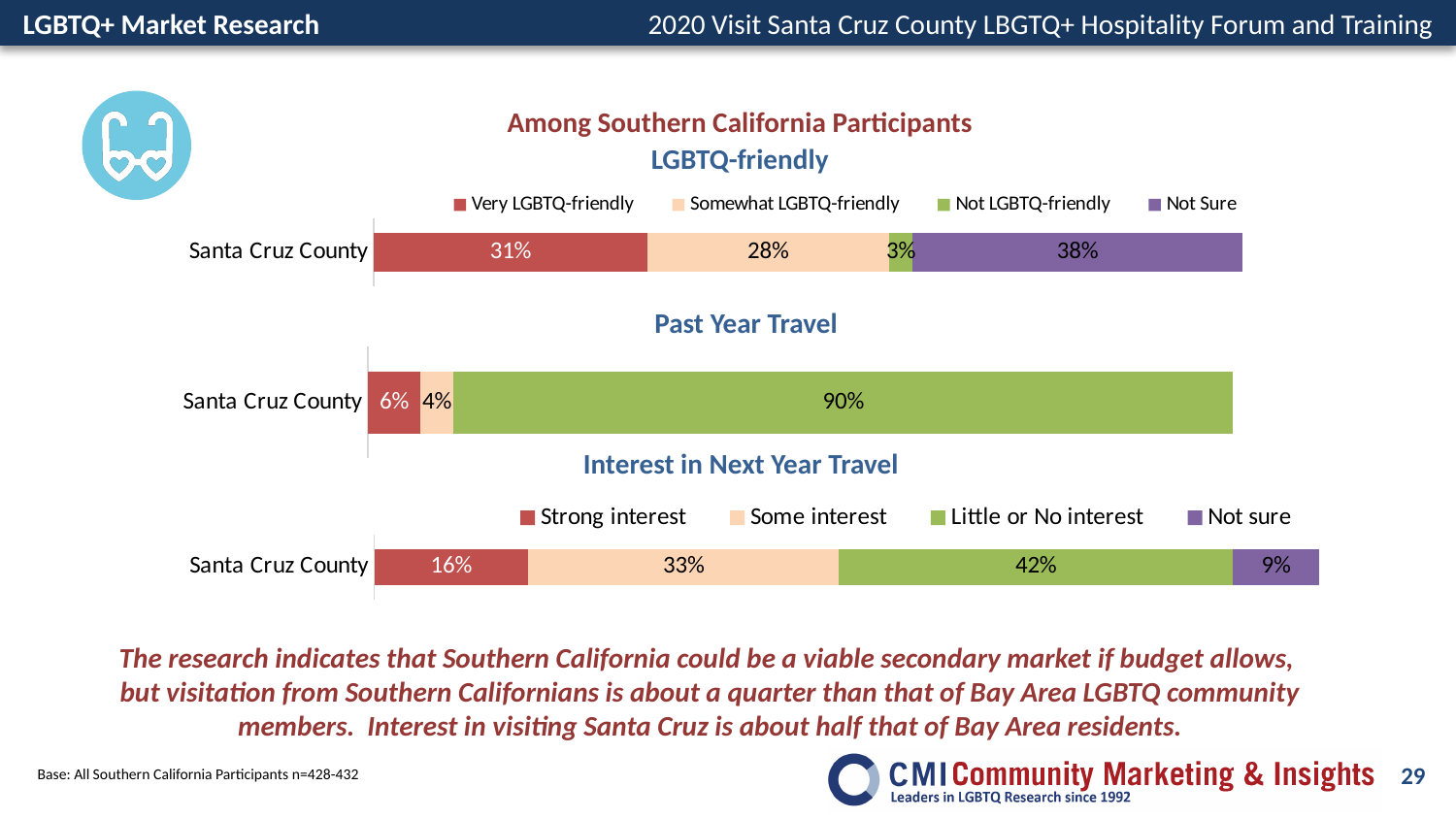
In the LGBTQ-friendly chart, what is the value for Not Sure for Santa Cruz County? 38% In the LGBTQ-friendly chart, which series has the largest value for Santa Cruz County? Not Sure In the LGBTQ-friendly chart, what is the difference between the Very LGBTQ-friendly and Somewhat LGBTQ-friendly values? 3% In the LGBTQ-friendly chart, what percentage of Southern California participants rated Santa Cruz County as Very LGBTQ-friendly? 31% In the LGBTQ-friendly chart, which series has the smallest value for Santa Cruz County? Not LGBTQ-friendly What type of chart is used for the Interest in Next Year Travel data? Stacked bar chart In the Interest in Next Year Travel chart, what is the difference between Little or No interest and Not sure? 33% In the Past Year Travel chart, what is the total of the three segments shown for Santa Cruz County? 100% How many series does the legend of the LGBTQ-friendly chart list? 4 In the Past Year Travel chart, what is the value of the largest segment of the Santa Cruz County bar? 90% In the Interest in Next Year Travel chart, which is larger for Santa Cruz County: Some interest or Little or No interest? Little or No interest In the Interest in Next Year Travel chart, what is the value for Strong interest for Santa Cruz County? 16%